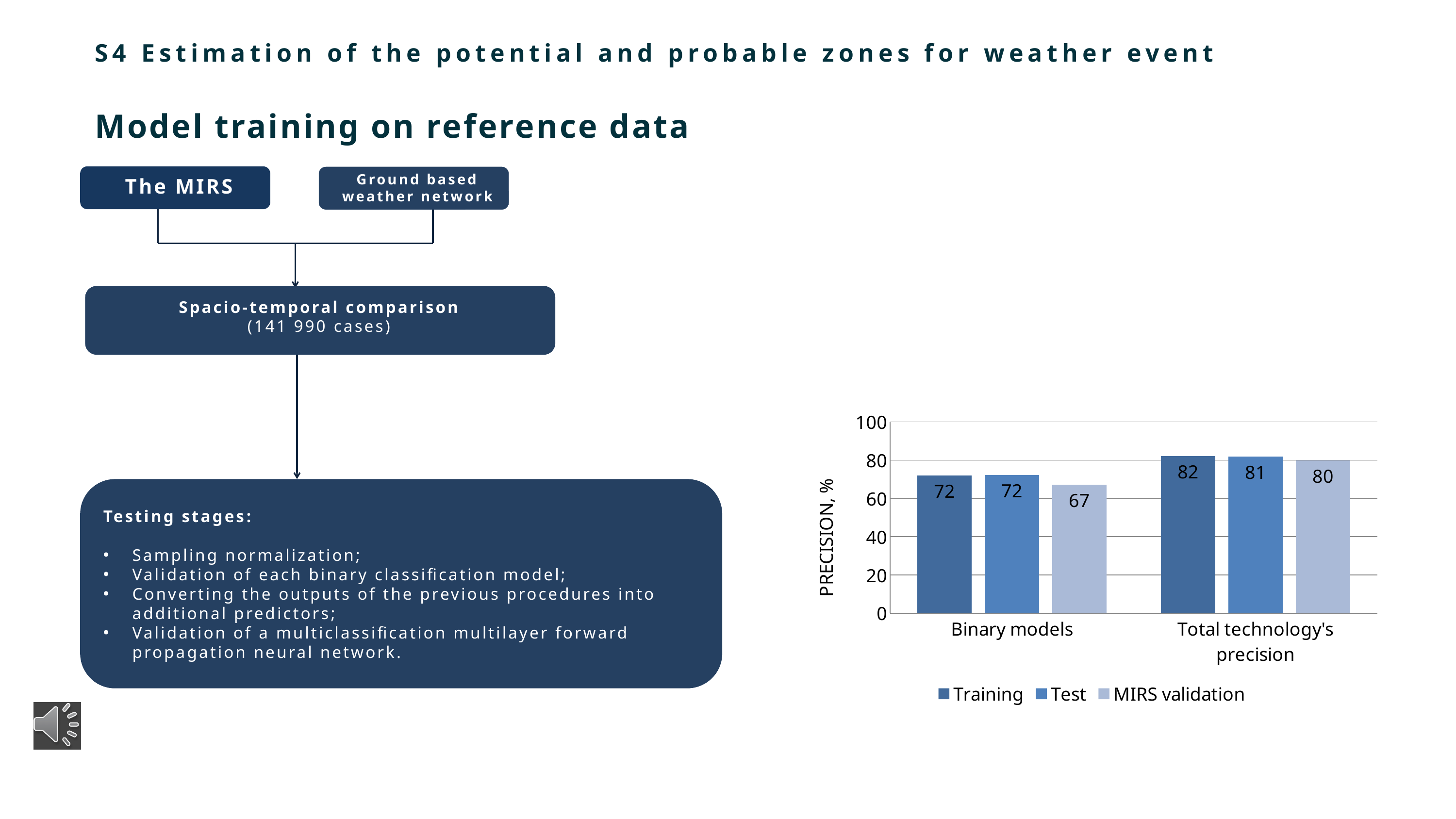
Which series has the lowest value for Binary models? MIRS validation What is the Training precision for Binary models? 72 What is the Test precision for Total technology's precision? 81 Which is larger: the MIRS validation value for Binary models or for Total technology's precision? Total technology's precision What is the Training precision for Total technology's precision? 82 How many series does the legend list? 3 What is the difference between the Training and MIRS validation values for Binary models? 5 What is the label of the vertical axis? PRECISION, % What kind of chart is shown on the slide? bar chart What is the difference between the Training values for Total technology's precision and Binary models? 10 How many categories are shown on the x axis? 2 What is the MIRS validation precision for Binary models? 67